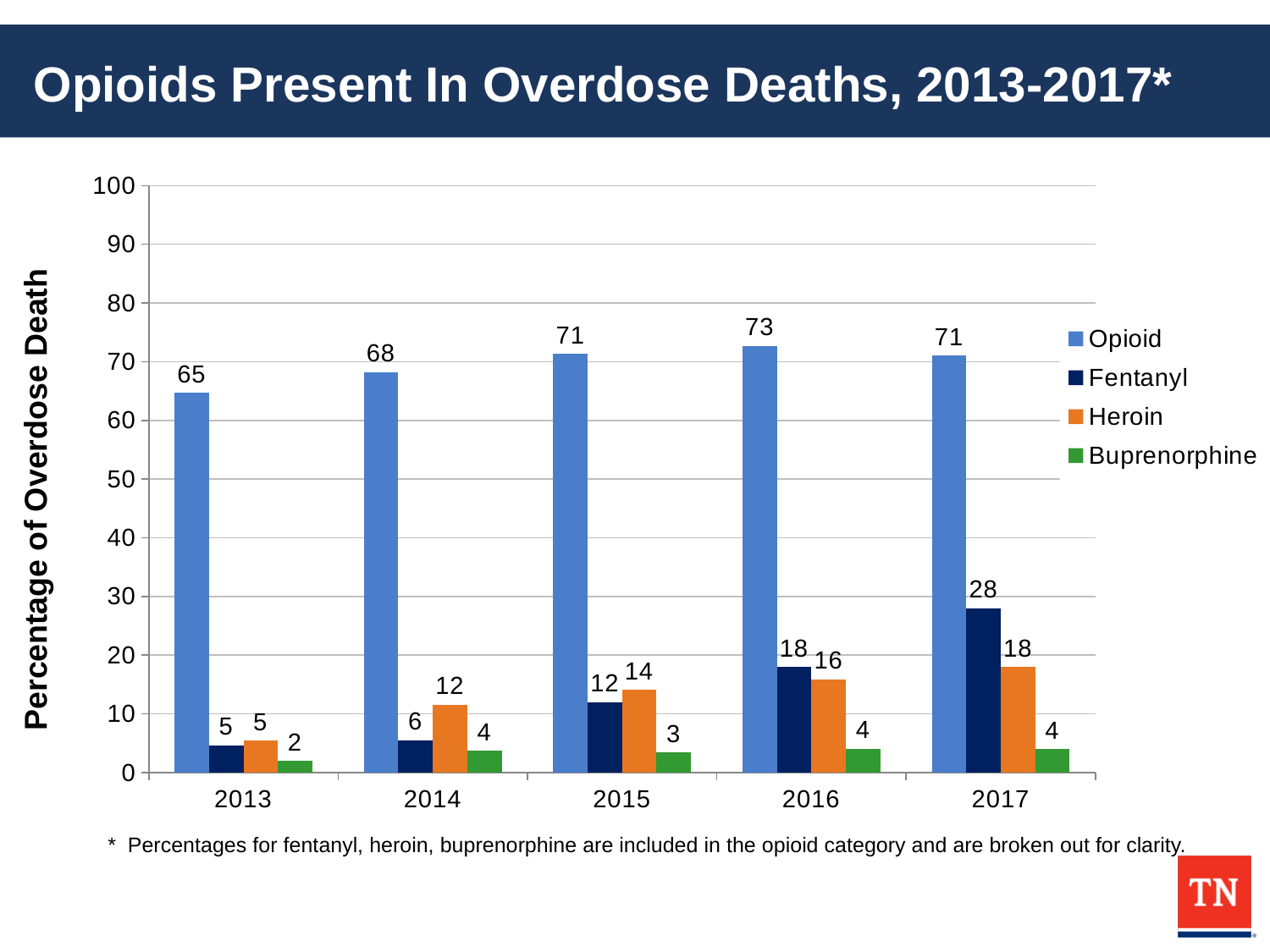
What is the difference between the Fentanyl values for 2017 and 2016? 10 How many series does the legend list? 4 Which is larger in 2015, the Fentanyl value or the Heroin value? Heroin How many years are shown on the x axis? 5 What is the Heroin value for 2014? 12 Does the Fentanyl value rise or fall from 2013 to 2017? Rise What kind of chart is shown on the slide? Bar chart In which year is the Fentanyl value lowest? 2013 What is the Buprenorphine value for 2013? 2 In which year is the Opioid value highest? 2016 What is the Fentanyl value for 2017? 28 What is the Opioid value for 2016? 73